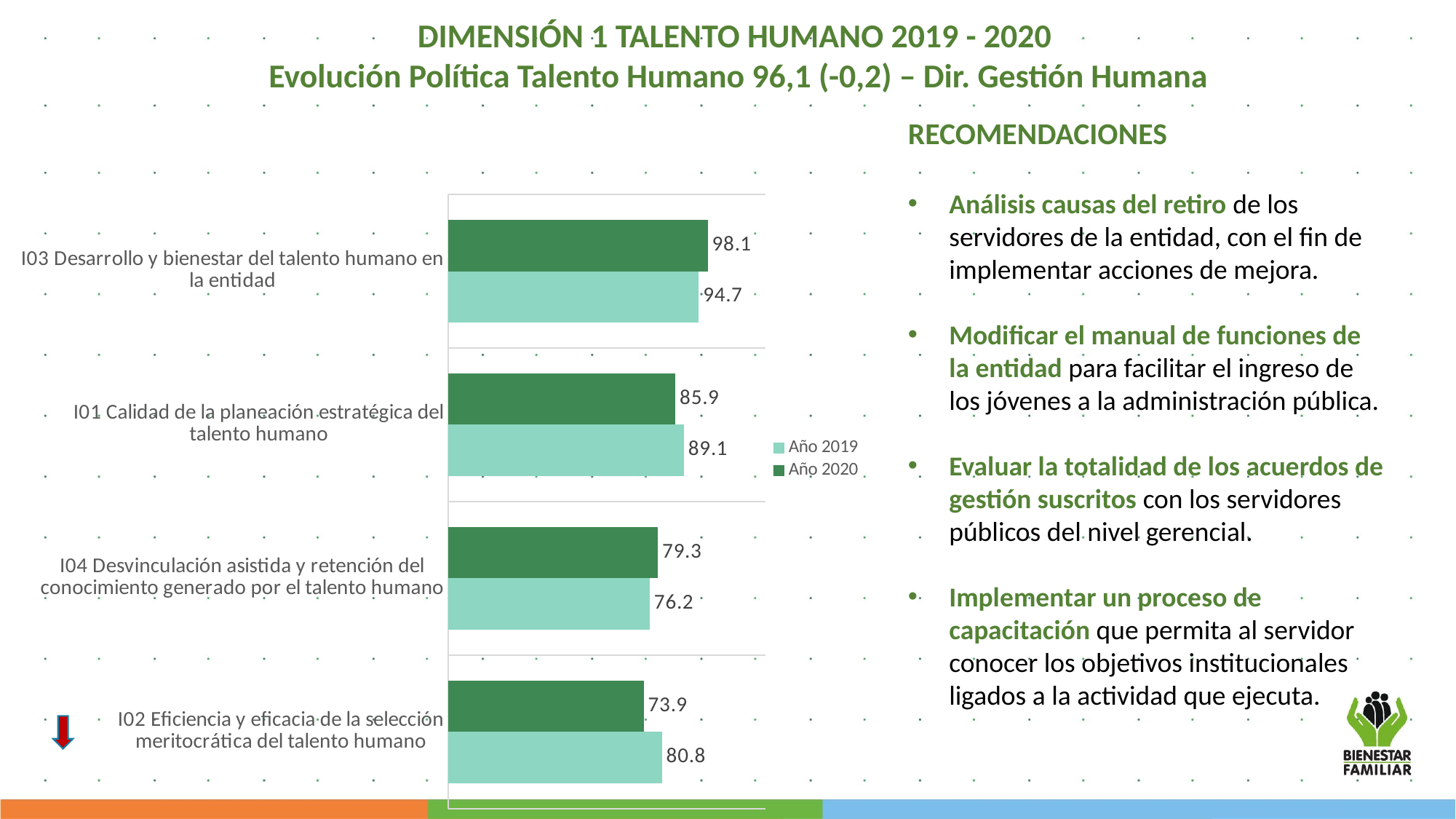
Which category has the lowest Año 2019 value? I04 Desvinculación asistida y retención del conocimiento generado por el talento humano What is the difference between the Año 2019 and Año 2020 values for I02 Eficiencia y eficacia de la selección meritocrática del talento humano? 6.9 For I04 Desvinculación asistida y retención del conocimiento generado por el talento humano, which is larger: the Año 2019 value or the Año 2020 value? Año 2020 How many categories are shown in the chart? 4 What is the Año 2019 value for I01 Calidad de la planeación estratégica del talento humano? 89.1 How many series does the legend list? 2 For I01 Calidad de la planeación estratégica del talento humano, which is larger: the Año 2019 value or the Año 2020 value? Año 2019 What is the Año 2020 value for I03 Desarrollo y bienestar del talento humano en la entidad? 98.1 What is the Año 2019 value for I02 Eficiencia y eficacia de la selección meritocrática del talento humano? 80.8 Which category has the highest Año 2020 value? I03 Desarrollo y bienestar del talento humano en la entidad What kind of chart is shown on the slide? Bar chart What is the difference between the Año 2020 and Año 2019 values for I03 Desarrollo y bienestar del talento humano en la entidad? 3.4